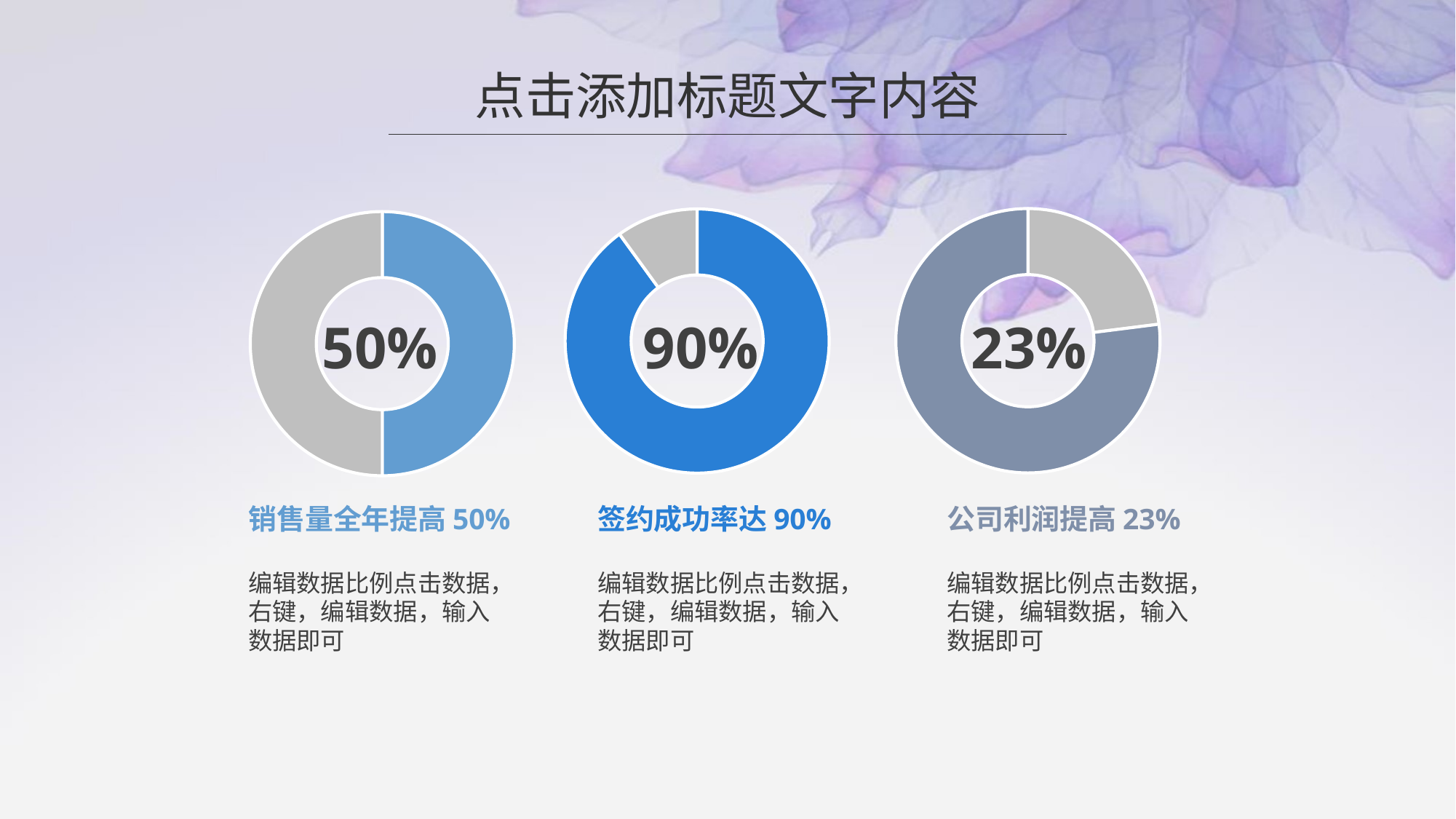
Is the percentage in the left chart larger or smaller than the percentage in the right chart? Larger What is the difference between the percentage in the middle chart and the percentage in the left chart? 40% What percentage is shown in the centre of the middle donut chart? 90% What is the caption under the middle donut chart? 签约成功率达 90% How many donut charts are on the slide? 3 What kind of charts are shown on the slide? Donut (pie) charts What is the difference between the percentage in the left chart and the percentage in the right chart? 27% Which of the three donut charts shows the highest percentage? The middle chart (90%) What is the caption under the right donut chart? 公司利润提高 23% Which of the three donut charts shows the lowest percentage? The right chart (23%) What percentage is shown in the centre of the right donut chart? 23% What percentage is shown in the centre of the left donut chart? 50%